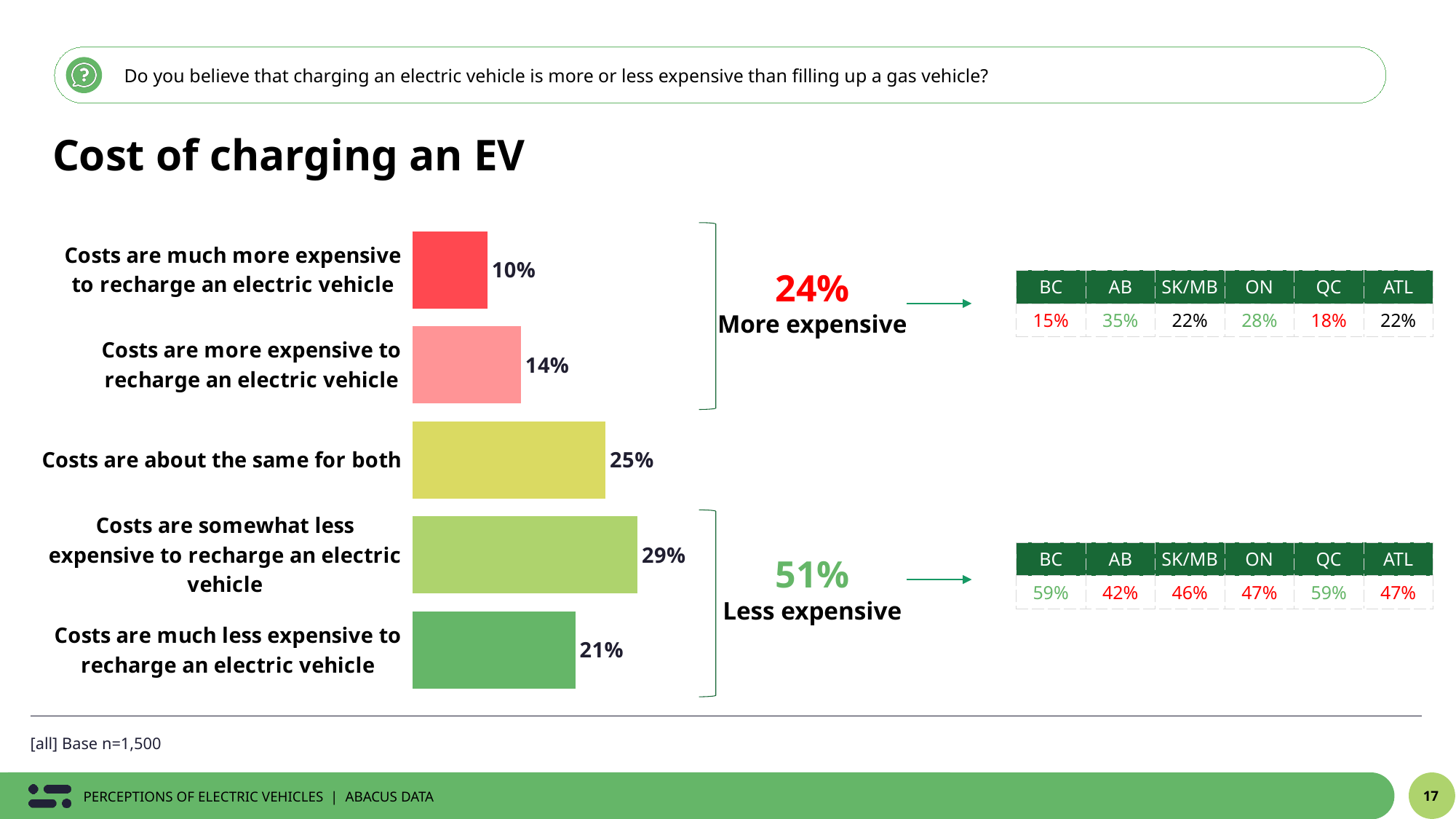
What percentage of respondents say costs are about the same for both? 25% Which is larger: the share saying costs are about the same for both, or the share saying costs are much less expensive? Costs are about the same for both What is the difference in percentage points between 'Costs are somewhat less expensive' and 'Costs are more expensive'? 15 What is the combined percentage for the 'More expensive' group shown on the slide? 24% What percentage of respondents say costs are much less expensive to recharge an electric vehicle? 21% In the 'Less expensive' regional table, what is the value for AB? 42% In the 'More expensive' regional table, which region has the highest value? AB Which response category has the highest percentage? Costs are somewhat less expensive to recharge an electric vehicle How many response categories are shown in the bar chart? 5 What kind of chart is used to show the response categories? Bar chart What percentage of respondents say costs are much more expensive to recharge an electric vehicle? 10% Which response category has the lowest percentage? Costs are much more expensive to recharge an electric vehicle